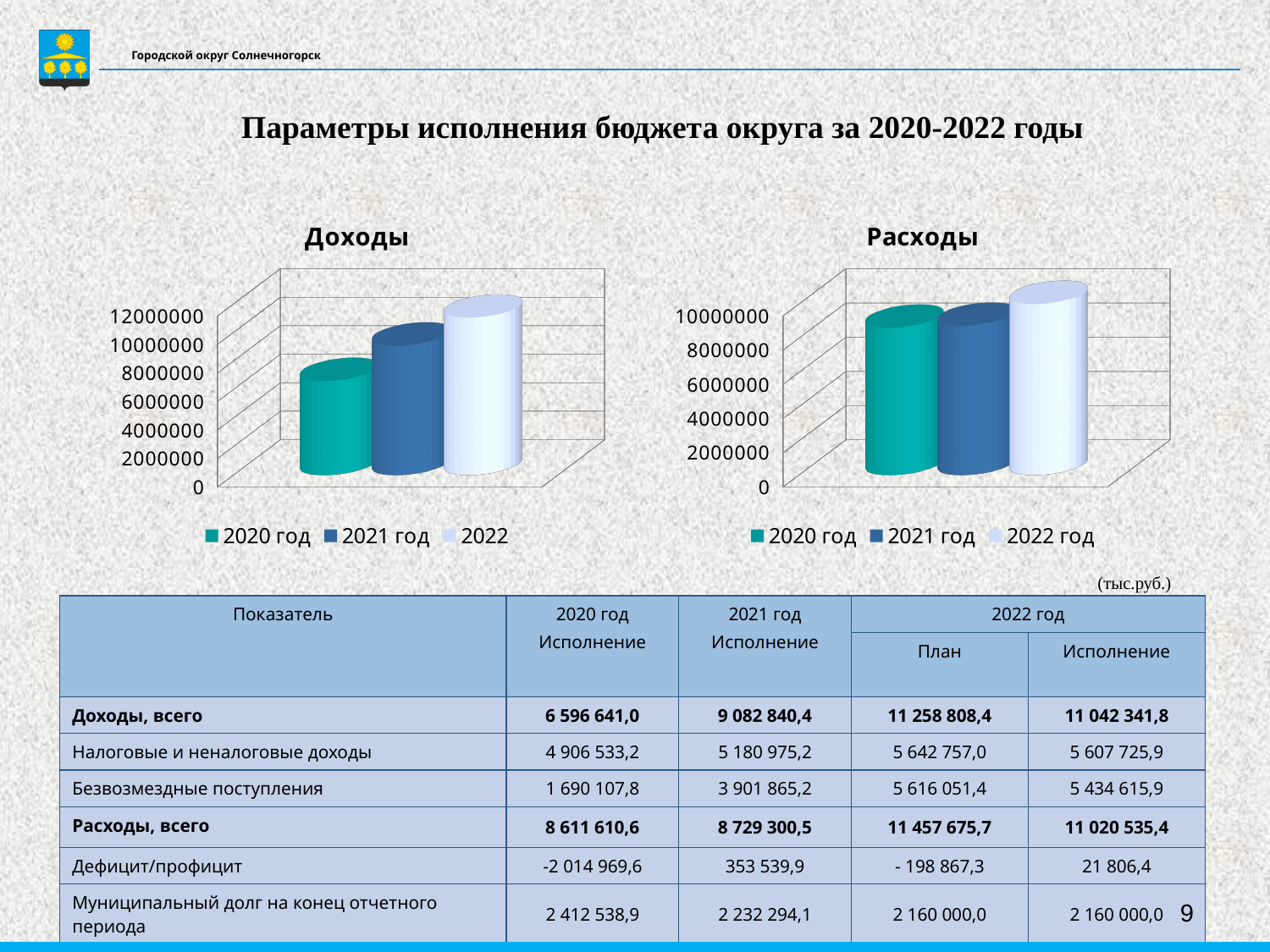
In the "Расходы" chart, is the value for 2021 год greater or less than 10000000? less What is the title of the chart on the right side of the slide? Расходы In the "Доходы" chart, is the value for 2022 greater or less than 10000000? greater In the "Доходы" chart, which series has the lowest value? 2020 год In the "Доходы" chart, which is larger: the value for 2021 год or the value for 2020 год? 2021 год Do the values in the "Доходы" chart rise or fall from 2020 to 2022? rise In the "Доходы" chart, which series has the highest value? 2022 In the "Расходы" chart, which series has the highest value? 2022 год In the "Доходы" chart, is the value for 2020 год greater or less than 8000000? less How many series does the legend of the "Расходы" chart list? 3 What kind of chart is the "Доходы" chart? bar chart